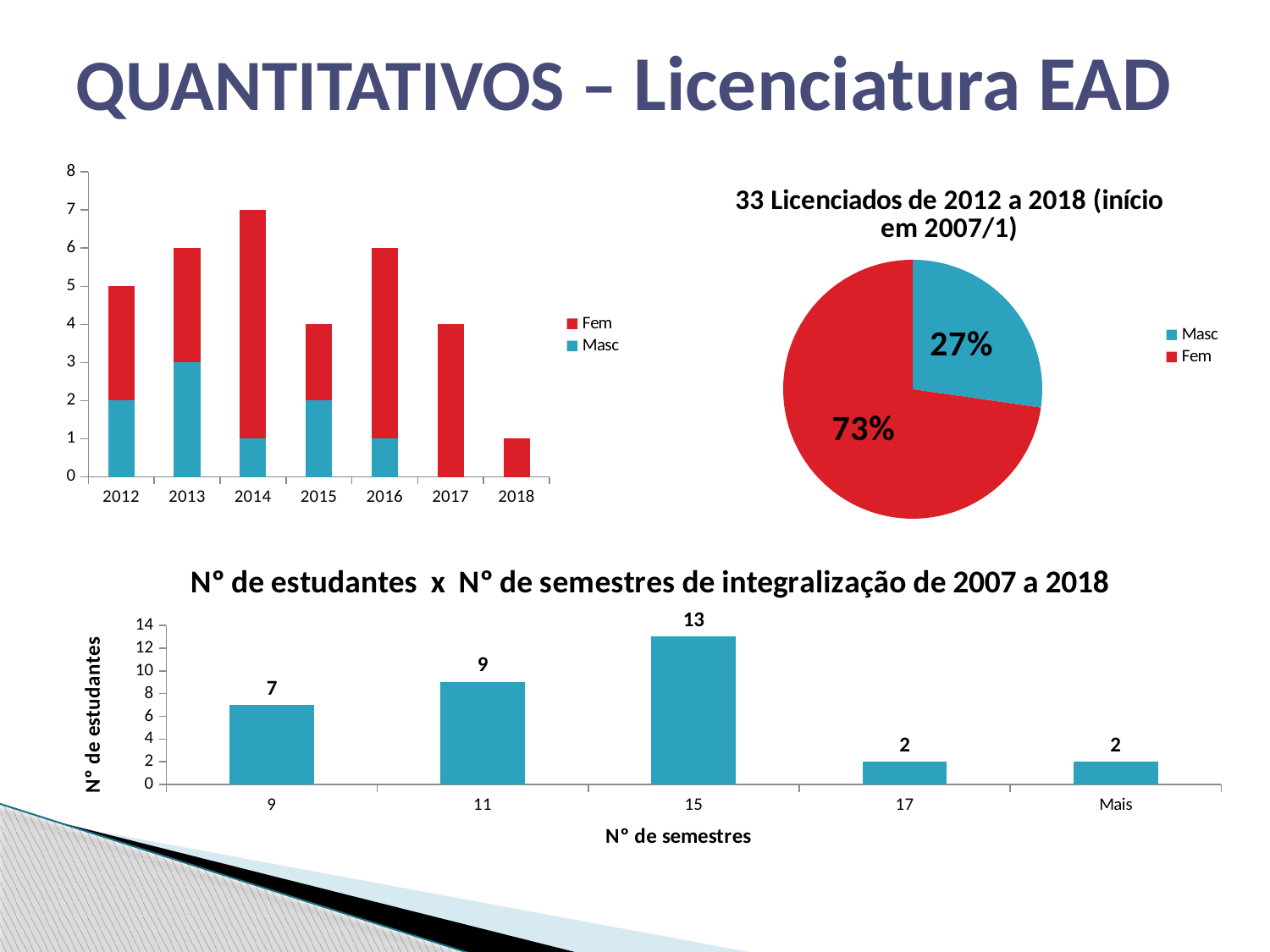
In the pie chart titled '33 Licenciados de 2012 a 2018 (início em 2007/1)', what share is Masc? 27% In the chart titled 'N° de estudantes x N° de semestres de integralização de 2007 a 2018', what is the difference between the values for 15 and 11 semesters? 4 In the top-left stacked bar chart, what is the total height of the bar for 2014? 7 In the top-left stacked bar chart, how many series does the legend list? 2 In the chart titled 'N° de estudantes x N° de semestres de integralização de 2007 a 2018', what is the value for 15 semesters? 13 In the top-left stacked bar chart, what is the Masc value for 2013? 3 In the top-left stacked bar chart, how many years are shown on the x axis? 7 In the pie chart titled '33 Licenciados de 2012 a 2018 (início em 2007/1)', which slice is larger, Masc or Fem? Fem In the top-left stacked bar chart, which year has the shortest bar? 2018 In the top-left stacked bar chart, which year has the tallest bar? 2014 In the chart titled 'N° de estudantes x N° de semestres de integralização de 2007 a 2018', what is the label of the y axis? N° de estudantes In the chart titled 'N° de estudantes x N° de semestres de integralização de 2007 a 2018', what kind of chart is it? bar chart